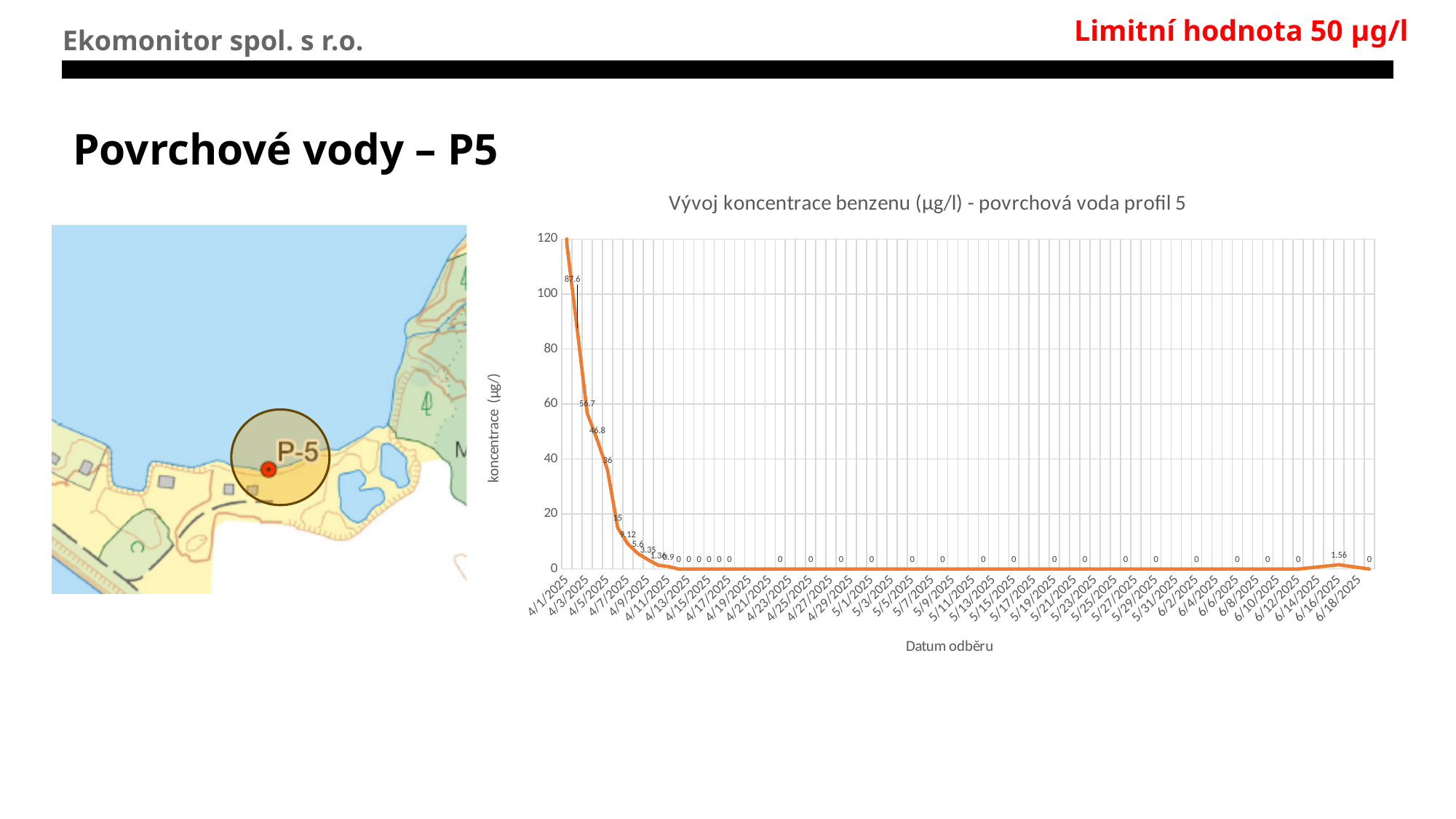
What is the benzene concentration value labelled at 6/16/2025? 1.56 Which date has the larger benzene concentration, 4/1/2025 or 6/18/2025? 4/1/2025 Is the value for 4/1/2025 greater or less than 100? greater What is the lowest value printed as a data label on the chart? 0 Do the benzene concentration values generally rise or fall along the x axis? fall What is the highest data label printed on the chart? 87.6 What kind of chart is shown on the slide? line chart Is the value for 4/3/2025 greater or less than 40? greater Is the value for 5/15/2025 greater or less than 20? less What is the x-axis title of the chart? Datum odběru What is the title of the chart? Vývoj koncentrace benzenu (µg/l) - povrchová voda profil 5